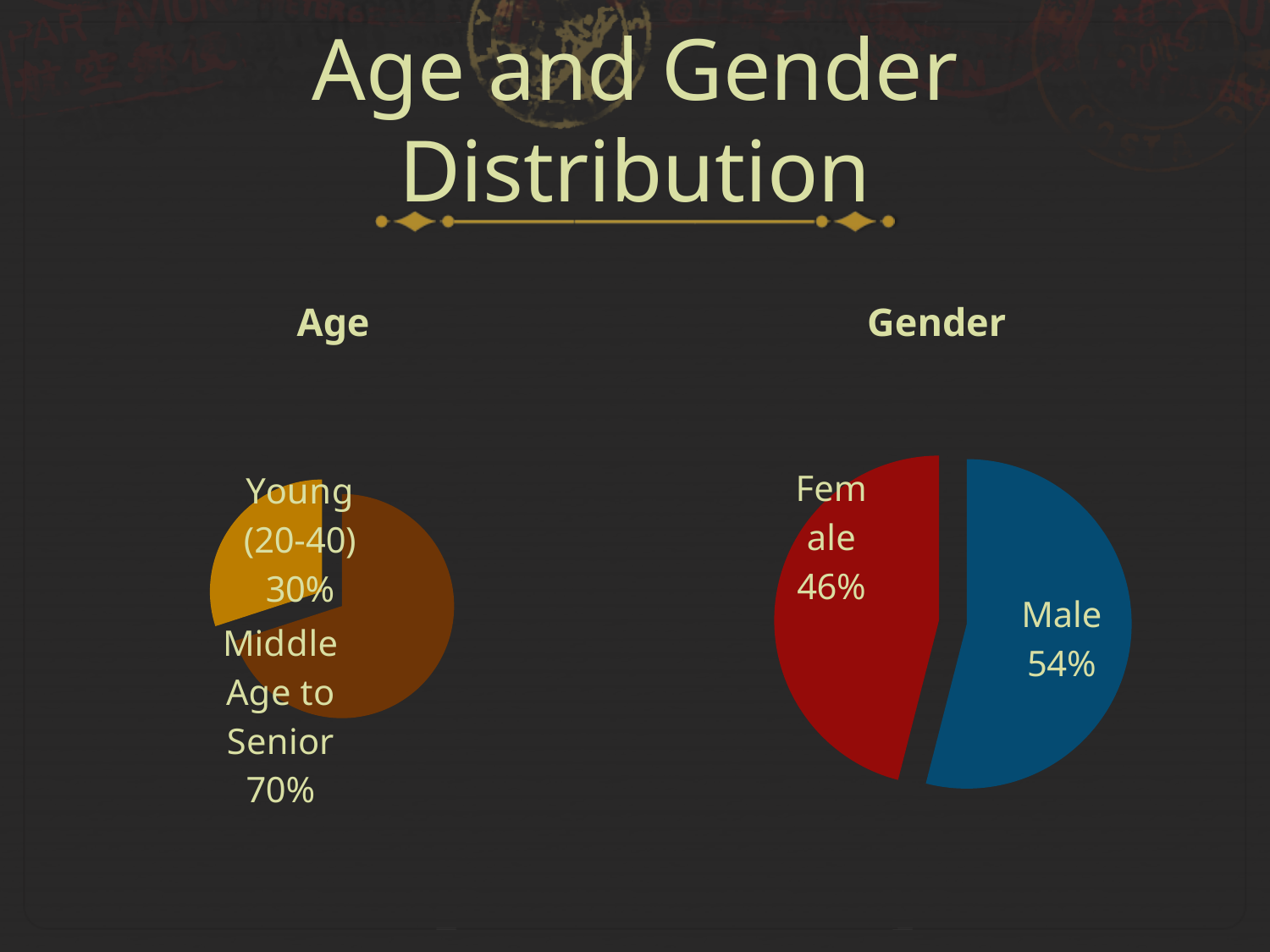
In the Age chart, what is the difference between the Middle Age to Senior and Young (20-40) shares? 40% In the Age chart, which category has the largest slice? Middle Age to Senior In the Gender chart, what is the value for Male? 54% In the Gender chart, what is the difference between the Male and Female values? 8% In the Gender chart, which category has the smallest slice? Female How many slices does the Age chart have? 2 What kind of chart is the Gender chart? Pie chart In the Gender chart, which is larger, Male or Female? Male In the Gender chart, what is the value for Female? 46% In the Age chart, what share does the Middle Age to Senior slice have? 70% In the Age chart, what share does the Young (20-40) slice have? 30% In the Gender chart, what colour is the Male slice? Blue